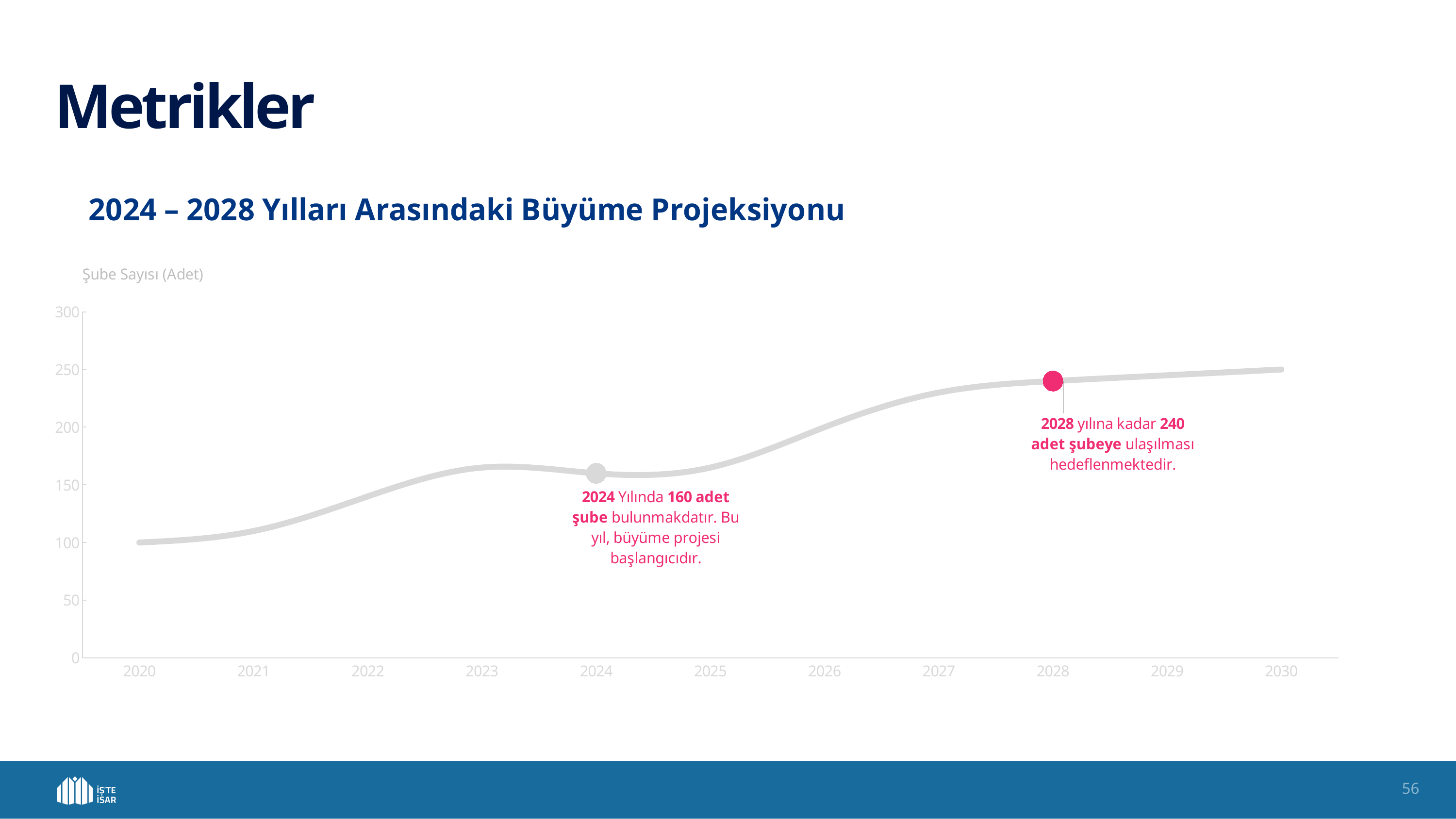
Do the values generally rise or fall from 2020 to 2030? rise What is the label of the y axis? Şube Sayısı (Adet) Which year has the lowest value on the chart? 2020 Is the value for 2022 greater or less than 100? greater What is the difference between the 2028 target and the 2024 branch count? 80 What kind of chart is shown on the slide? line chart What is the targeted number of branches for 2028? 240 How many years are shown on the x axis? 11 Is the value for 2027 greater or less than 200? greater Which is larger, the value for 2024 or the value for 2028? 2028 Is the value for 2021 greater or less than 150? less What is the number of branches (Şube Sayısı) in 2024? 160